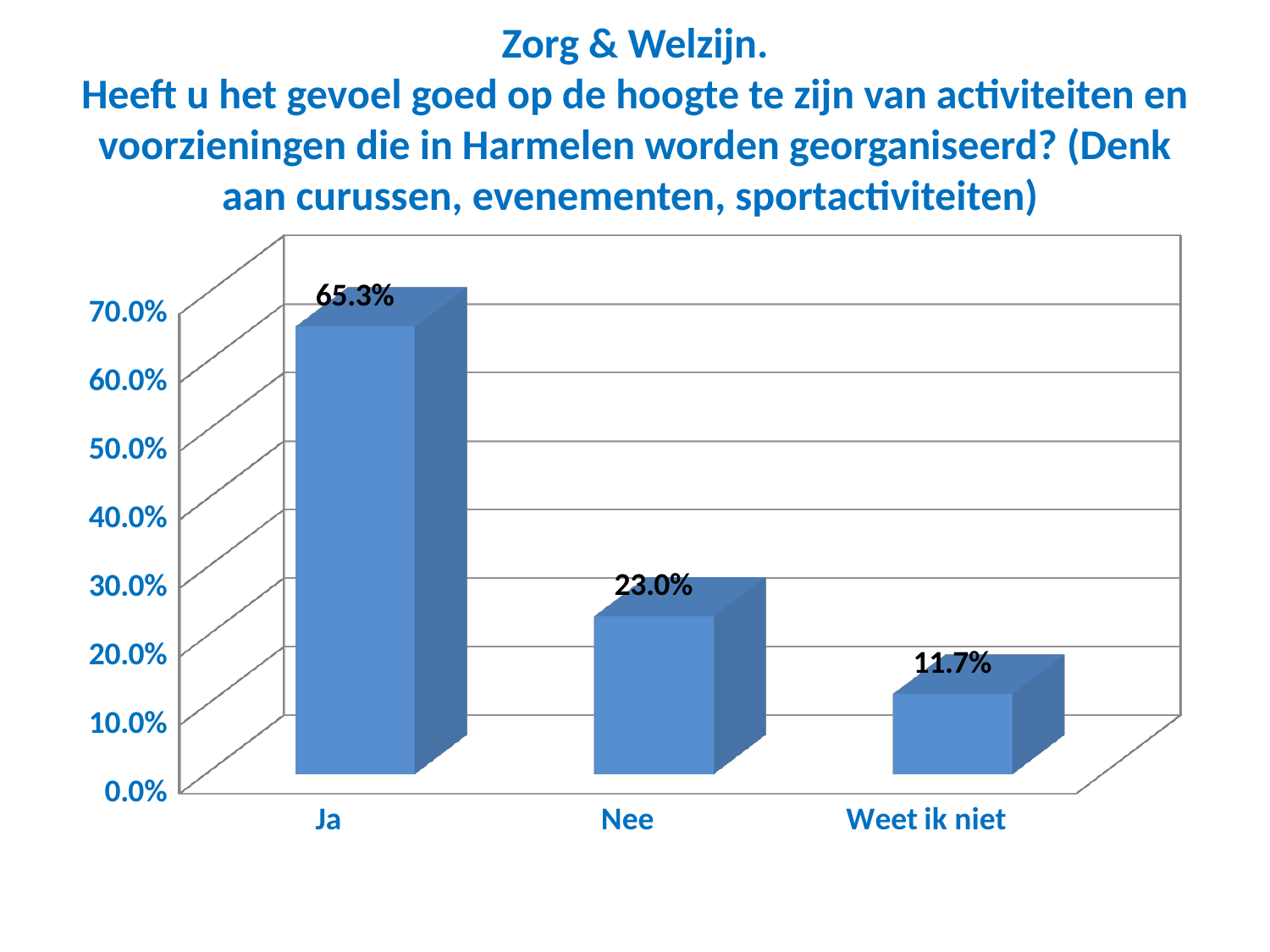
How many categories are shown on the x axis? 3 What is the difference between the values for "Nee" and "Weet ik niet"? 11.3% What is the value for "Ja"? 65.3% Which category has the highest value? Ja What is the value for "Weet ik niet"? 11.7% What is the difference between the values for "Ja" and "Nee"? 42.3% Is the value for "Ja" greater or less than 60.0%? greater Which category has the lowest value? Weet ik niet What kind of chart is shown on the slide? Bar chart Do the values rise or fall from left to right along the x axis? Fall Which is larger, the value for "Nee" or the value for "Weet ik niet"? Nee What is the value for "Nee"? 23.0%